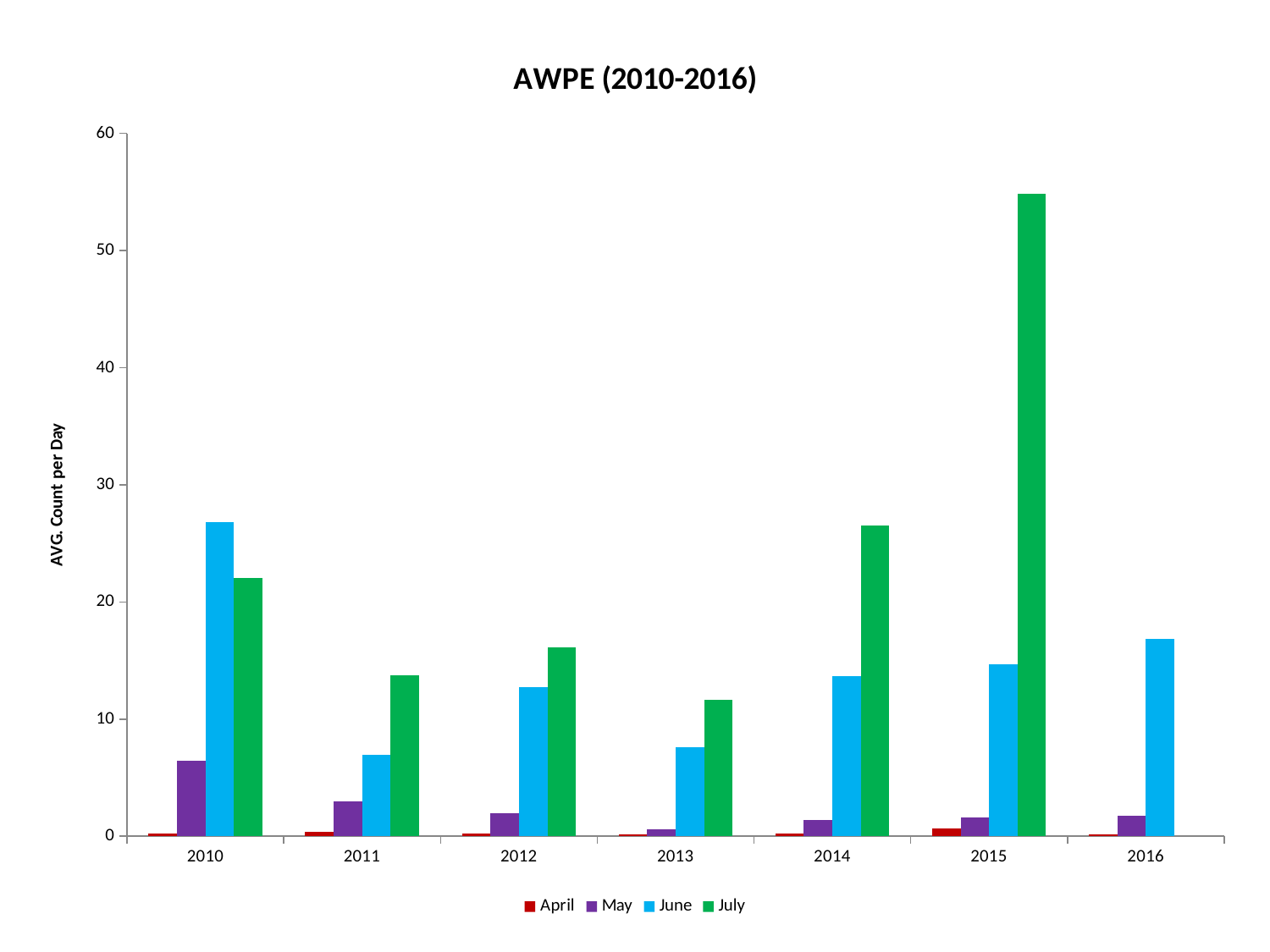
In 2014, which is larger, the June value or the July value? July What is the title of the chart? AWPE (2010-2016) How many years are shown on the x axis? 7 How many series does the legend list? 4 Is the July value for 2015 greater or less than 50? greater In 2010, which is larger, the June value or the July value? June Which month has the highest bar in 2012? July What kind of chart is shown on the slide? bar chart Is the May value for 2010 greater or less than 10? less Which year has the highest July bar? 2015 What is the label on the y axis? AVG. Count per Day Is the June value for 2010 greater or less than 20? greater